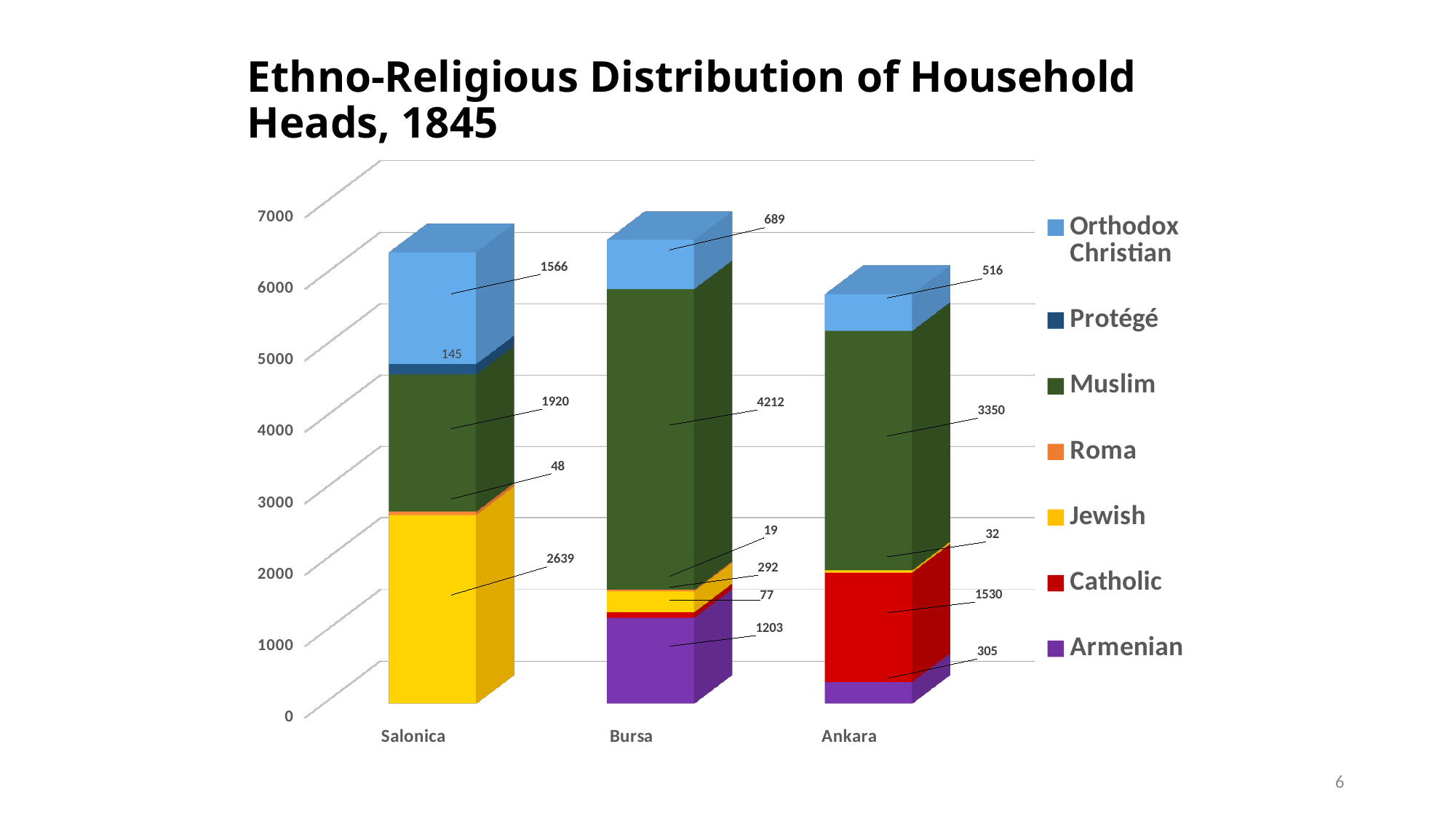
What kind of chart is shown on the slide? Stacked bar chart How many cities are shown on the x axis? 3 Which city has the lowest Orthodox Christian value? Ankara Which city has the highest Muslim value? Bursa What is the difference between the Muslim values for Bursa and Ankara? 862 What is the value for Jewish in Salonica? 2639 Which is larger, the Armenian value for Bursa or for Ankara? Bursa What is the value for Catholic in Ankara? 1530 How many series does the legend list? 7 What is the value for Muslim in Bursa? 4212 What is the difference between the Orthodox Christian values for Salonica and Bursa? 877 What is the value for Protégé in Salonica? 145